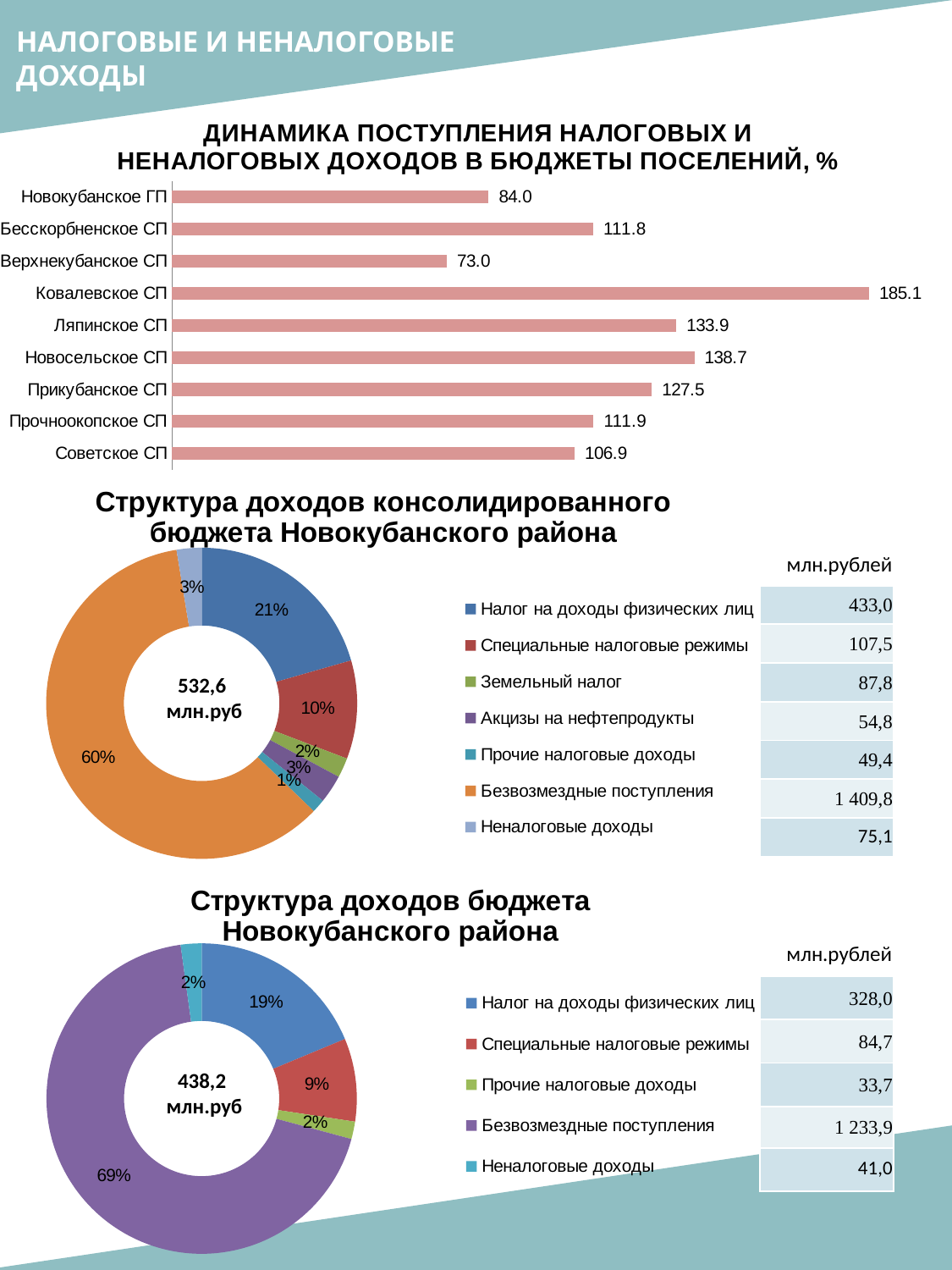
What type of chart is 'Динамика поступления налоговых и неналоговых доходов в бюджеты поселений, %'? Bar chart In the bar chart 'Динамика поступления налоговых и неналоговых доходов в бюджеты поселений, %', which is larger: Прикубанское СП or Бесскорбненское СП? Прикубанское СП What total is shown in the centre of the doughnut chart 'Структура доходов бюджета Новокубанского района'? 438,2 млн.руб In the doughnut chart 'Структура доходов бюджета Новокубанского района', what share is Налог на доходы физических лиц? 19% In the doughnut chart 'Структура доходов консолидированного бюджета Новокубанского района', what share is Безвозмездные поступления? 60% In the bar chart 'Динамика поступления налоговых и неналоговых доходов в бюджеты поселений, %', which settlement has the highest value? Ковалевское СП In the bar chart 'Динамика поступления налоговых и неналоговых доходов в бюджеты поселений, %', what is the value for Советское СП? 106.9 How many settlements are shown in the bar chart 'Динамика поступления налоговых и неналоговых доходов в бюджеты поселений, %'? 9 In the bar chart 'Динамика поступления налоговых и неналоговых доходов в бюджеты поселений, %', which settlement has the lowest value? Верхнекубанское СП In the bar chart 'Динамика поступления налоговых и неналоговых доходов в бюджеты поселений, %', what is the difference between Новосельское СП and Ляпинское СП? 4.8 In the bar chart 'Динамика поступления налоговых и неналоговых доходов в бюджеты поселений, %', what is the value for Ковалевское СП? 185.1 How many entries does the legend of the doughnut chart 'Структура доходов консолидированного бюджета Новокубанского района' list? 7